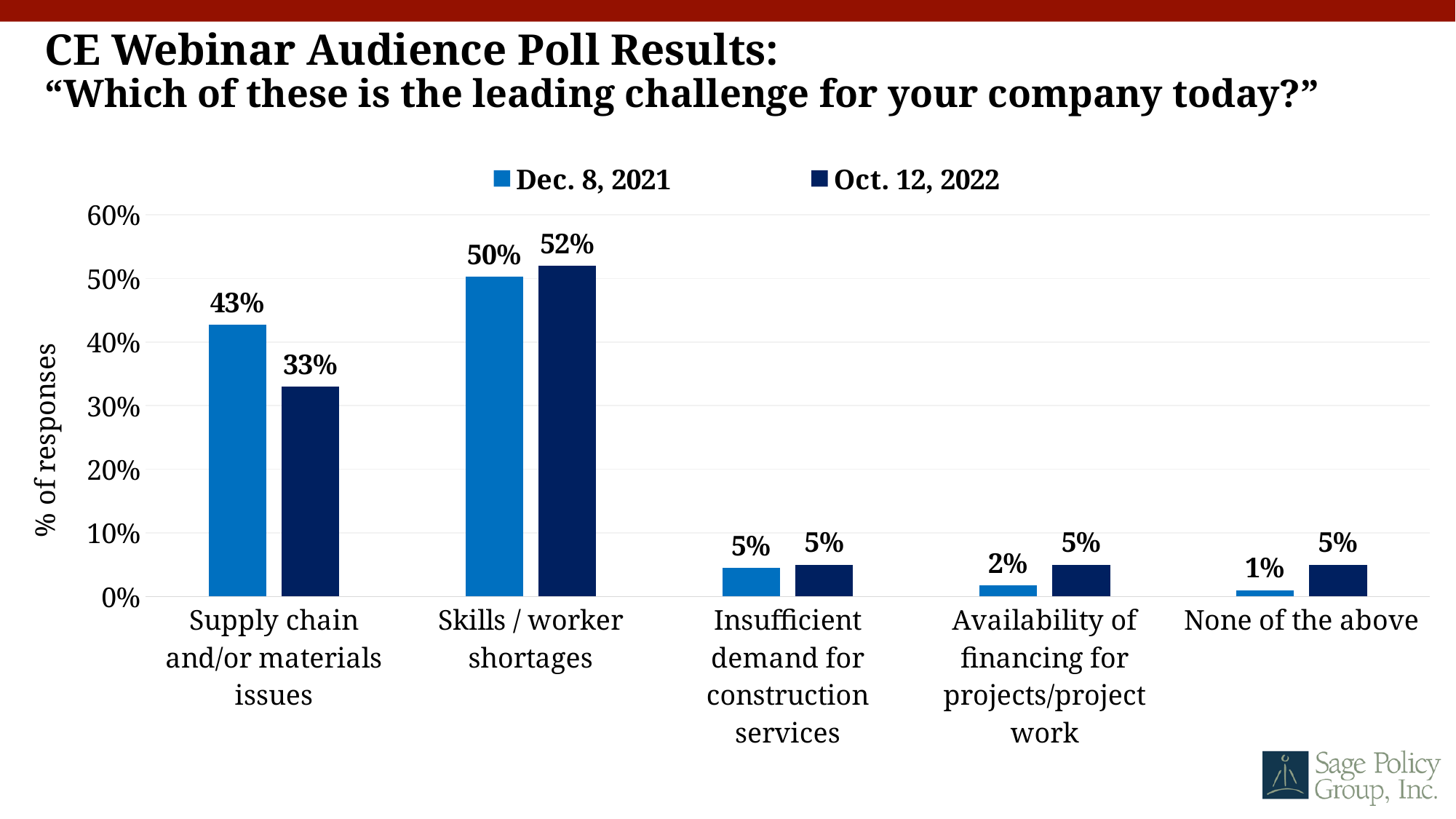
What percentage of responses chose None of the above on Dec. 8, 2021? 1% Which is larger: the Dec. 8, 2021 value for Availability of financing for projects/project work or the Oct. 12, 2022 value for the same category? Oct. 12, 2022 What percentage of responses chose Skills / worker shortages on Oct. 12, 2022? 52% What kind of chart is shown on the slide? Bar chart Is the Oct. 12, 2022 value for Supply chain and/or materials issues greater or less than 40%? less Which challenge received the highest share of responses on Oct. 12, 2022? Skills / worker shortages Which challenge received the lowest share of responses on Dec. 8, 2021? None of the above How many challenge categories are shown on the x axis? 5 What percentage of responses chose Supply chain and/or materials issues on Dec. 8, 2021? 43% By how many percentage points did the share for Supply chain and/or materials issues change from Dec. 8, 2021 to Oct. 12, 2022? 10 percentage points lower What is the label of the y axis? % of responses How many series does the legend list? 2